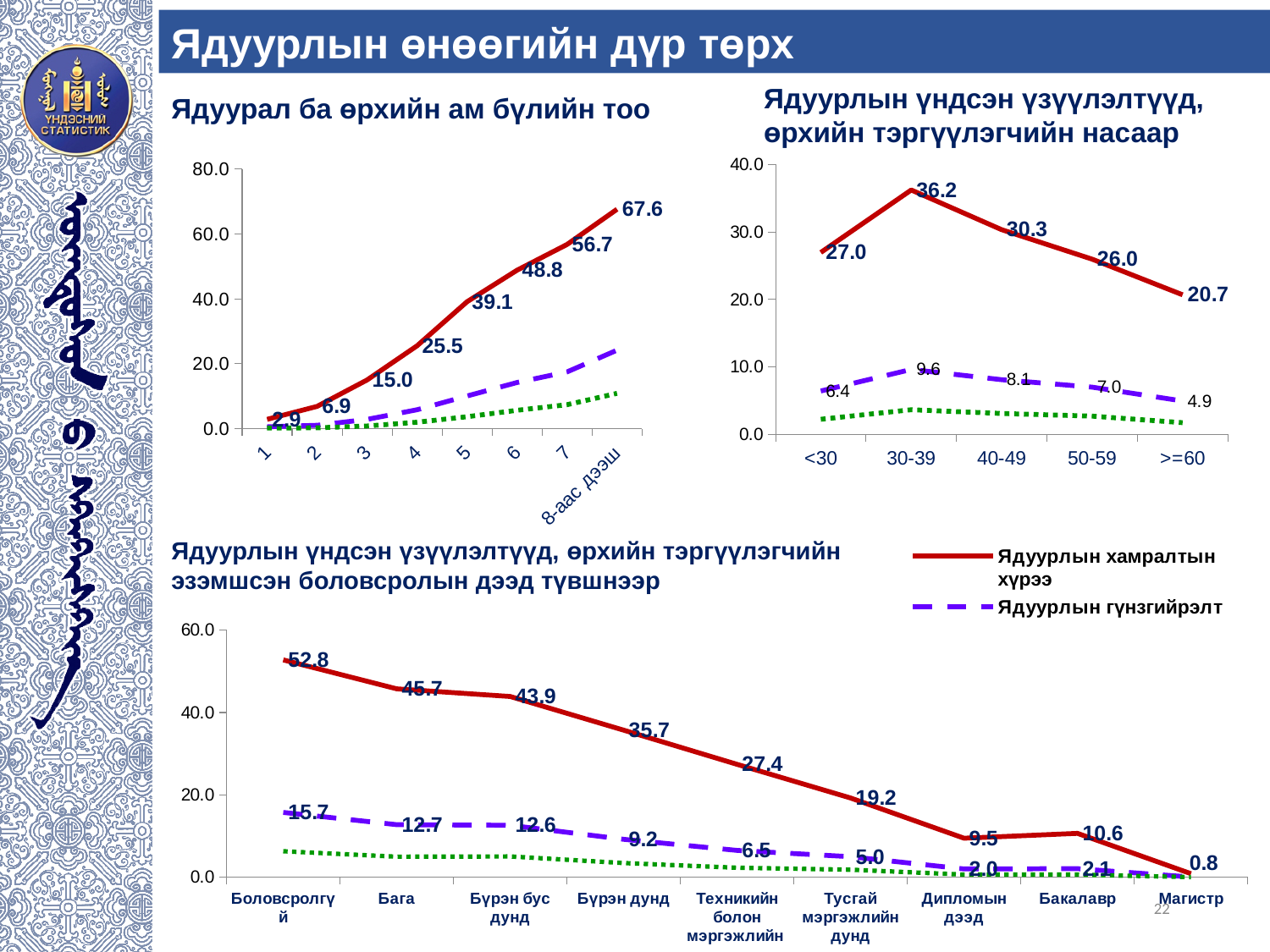
In the chart 'Ядуурал ба өрхийн ам бүлийн тоо', what is the difference between the red line values for household sizes 7 and 6? 7.9 What kind of chart is the bottom chart by education level? line chart In the bottom chart by education level, what is the value of the red line for 'Бүрэн дунд'? 35.7 In the bottom chart by education level, is the red line value for 'Бакалавр' larger or smaller than for 'Дипломын дээд'? larger In the chart 'Ядуурлын үндсэн үзүүлэлтүүд, өрхийн тэргүүлэгчийн насаар', how many age groups are shown on the x axis? 5 In the chart 'Ядуурлын үндсэн үзүүлэлтүүд, өрхийн тэргүүлэгчийн насаар', what is the value of the purple dashed line for the 50-59 age group? 7.0 In the chart 'Ядуурлын үндсэн үзүүлэлтүүд, өрхийн тэргүүлэгчийн насаар', what is the difference between the red line values for 30-39 and >=60? 15.5 In the chart 'Ядуурлын үндсэн үзүүлэлтүүд, өрхийн тэргүүлэгчийн насаар', which age group has the highest value on the red line? 30-39 In the chart 'Ядуурал ба өрхийн ам бүлийн тоо', does the red line rise or fall as household size increases? rises In the chart 'Ядуурал ба өрхийн ам бүлийн тоо', what is the value of the red line for household size 5? 39.1 In the chart 'Ядуурал ба өрхийн ам бүлийн тоо', what is the value of the red line for '8-аас дээш'? 67.6 In the bottom chart by education level, which category has the lowest value on the red line? Магистр